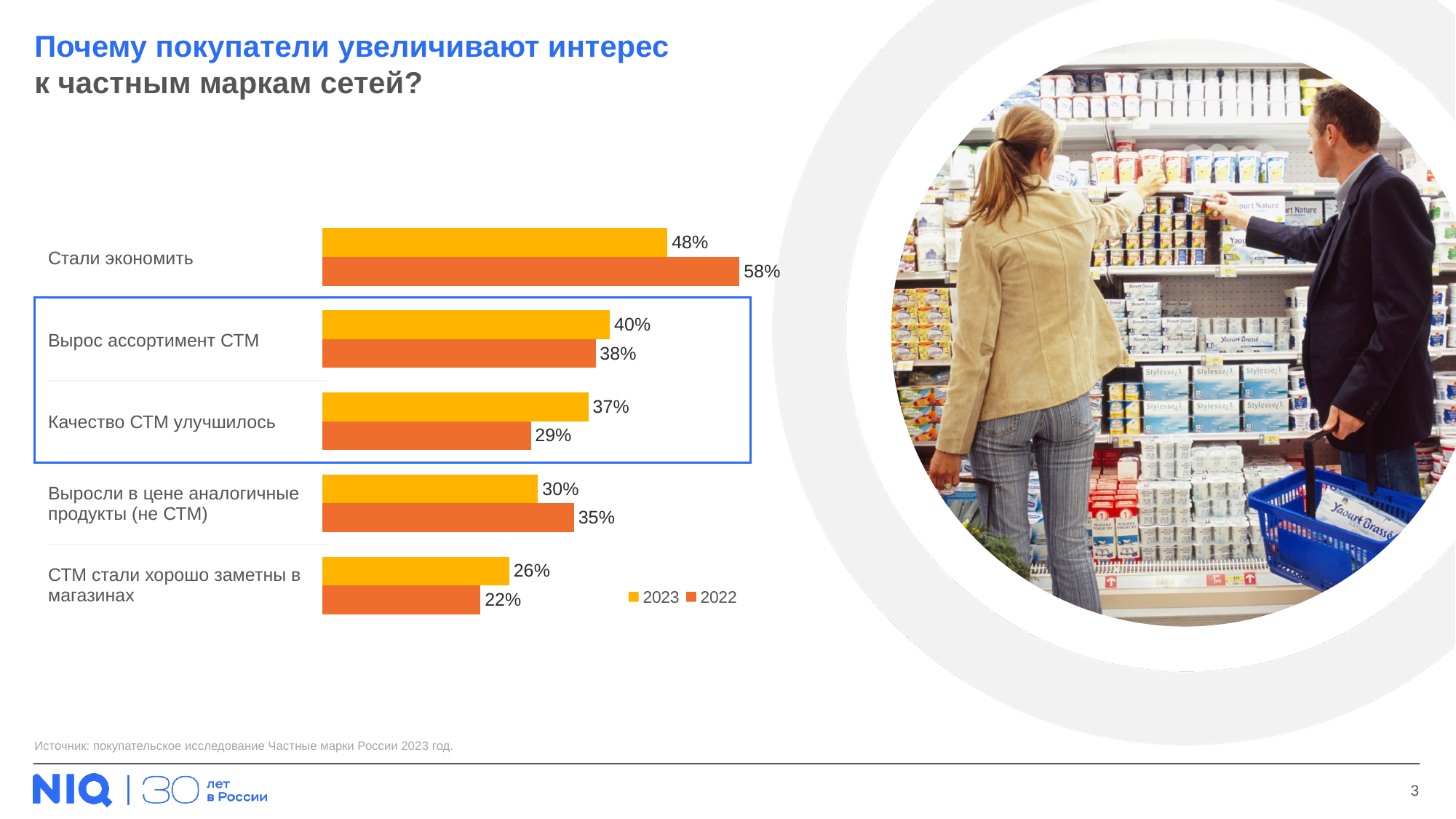
What is the 2022 value for "Качество СТМ улучшилось"? 29% How many series does the legend list? 2 What is the difference between the 2023 and 2022 values for "Качество СТМ улучшилось"? 8% What is the difference between the 2022 and 2023 values for "Стали экономить"? 10% What type of chart is shown on the slide? Bar chart Which category has the highest 2022 value? Стали экономить How many categories are shown in the chart? 5 For "Вырос ассортимент СТМ", which year has the larger value, 2023 or 2022? 2023 Which category has the lowest 2023 value? СТМ стали хорошо заметны в магазинах What is the 2023 value for "Стали экономить"? 48% Which series is shown in orange in the legend? 2022 What is the 2022 value for "Выросли в цене аналогичные продукты (не СТМ)"? 35%